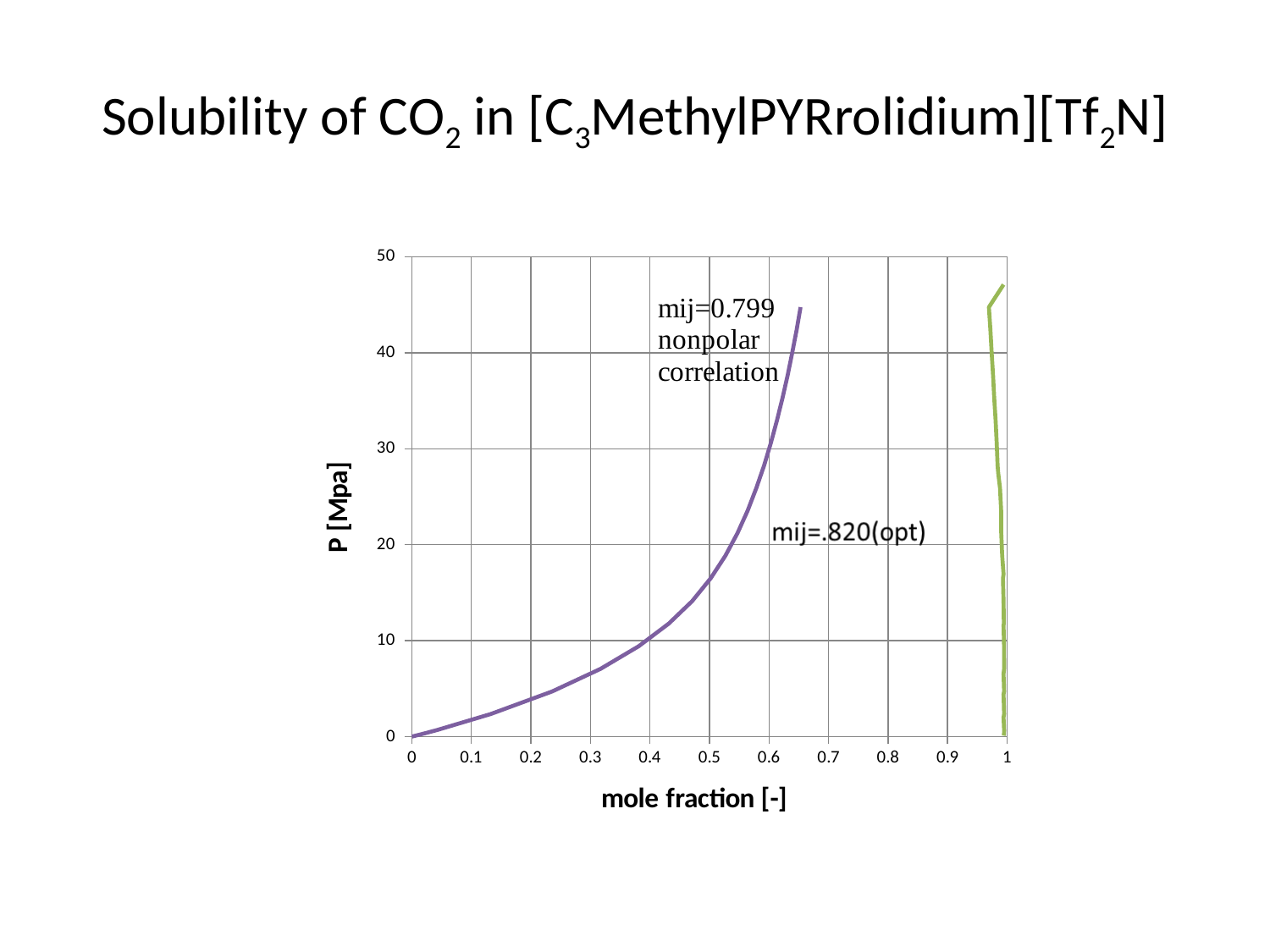
Is the pressure on the purple curve at a mole fraction of 0.3 greater or less than 10? less How many curves are plotted on the chart? 2 Is the pressure on the purple curve at a mole fraction of 0.6 greater or less than 20? greater Is the pressure on the purple curve at a mole fraction of 0.5 greater or less than 20? less What is the title of the chart's y axis? P [Mpa] What is the title of the chart's x axis? mole fraction [-] Which curve reaches higher mole fractions, the purple curve or the green curve? the green curve What kind of chart is shown on the slide? line chart Does the pressure on the purple curve rise or fall as the mole fraction increases? rise What is the maximum value shown on the y axis? 50